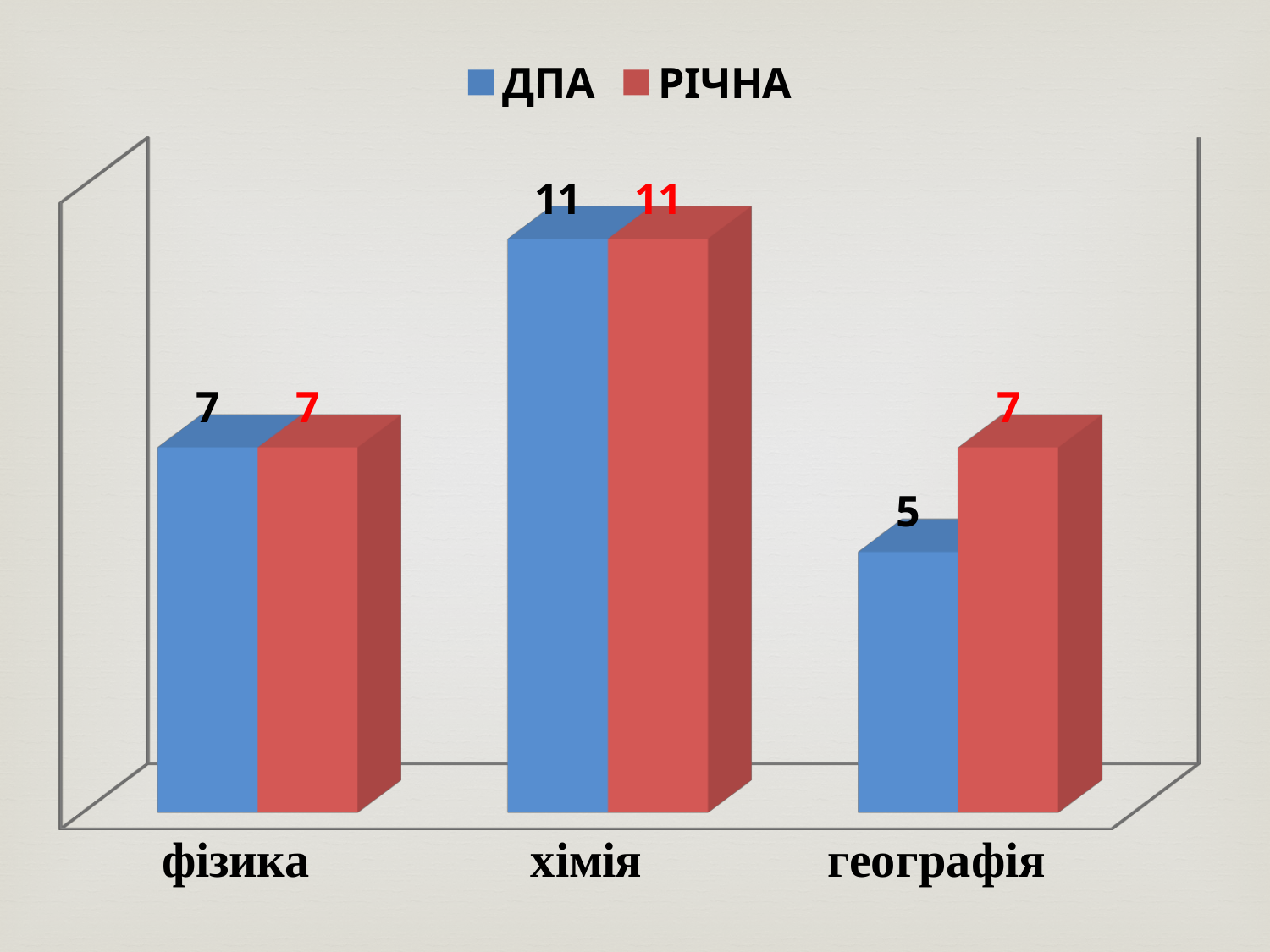
What is the difference between the РІЧНА and ДПА values for географія? 2 Which is larger for географія, the ДПА value or the РІЧНА value? РІЧНА Which category has the highest ДПА value? хімія What is the РІЧНА value for географія? 7 How many series does the legend list? 2 What is the difference between the ДПА values for хімія and фізика? 4 What is the ДПА value for фізика? 7 What kind of chart is shown on the slide? bar chart How many categories are shown on the x axis? 3 Which category has the lowest ДПА value? географія What is the ДПА value for географія? 5 What is the РІЧНА value for хімія? 11